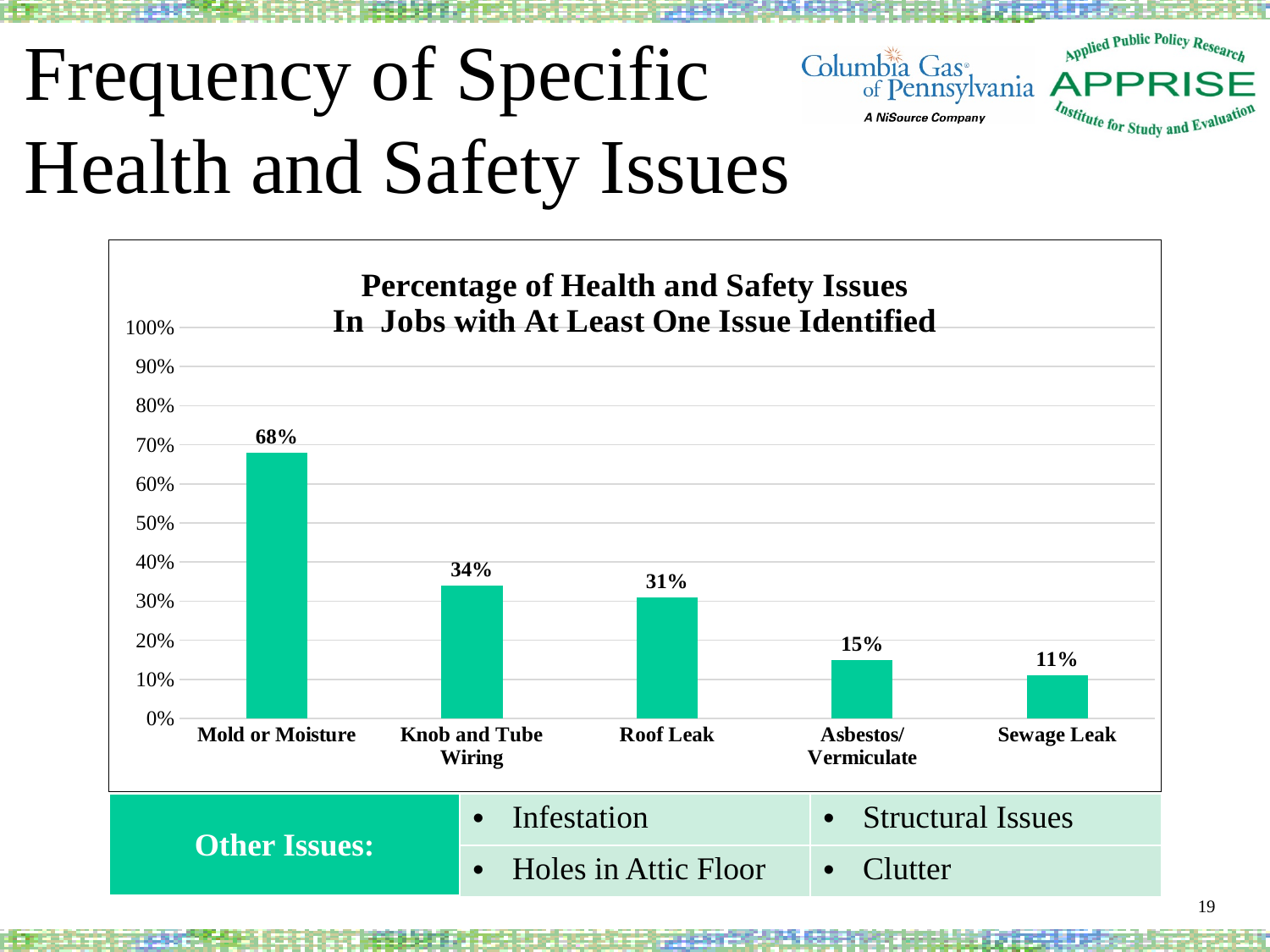
What percentage is shown for Mold or Moisture? 68% Which is larger, the value for Knob and Tube Wiring or the value for Roof Leak? Knob and Tube Wiring Is the value for Asbestos/Vermiculate greater or less than 20%? less What kind of chart is shown on the slide? bar chart Which health and safety issue has the highest percentage? Mold or Moisture What is the difference in percentage points between Mold or Moisture and Roof Leak? 37 What is the difference in percentage points between Asbestos/Vermiculate and Sewage Leak? 4 Which health and safety issue has the lowest percentage? Sewage Leak What percentage is shown for Sewage Leak? 11% What is the title of the chart? Percentage of Health and Safety Issues In Jobs with At Least One Issue Identified What percentage is shown for Knob and Tube Wiring? 34% How many health and safety issue categories are plotted in the chart? 5